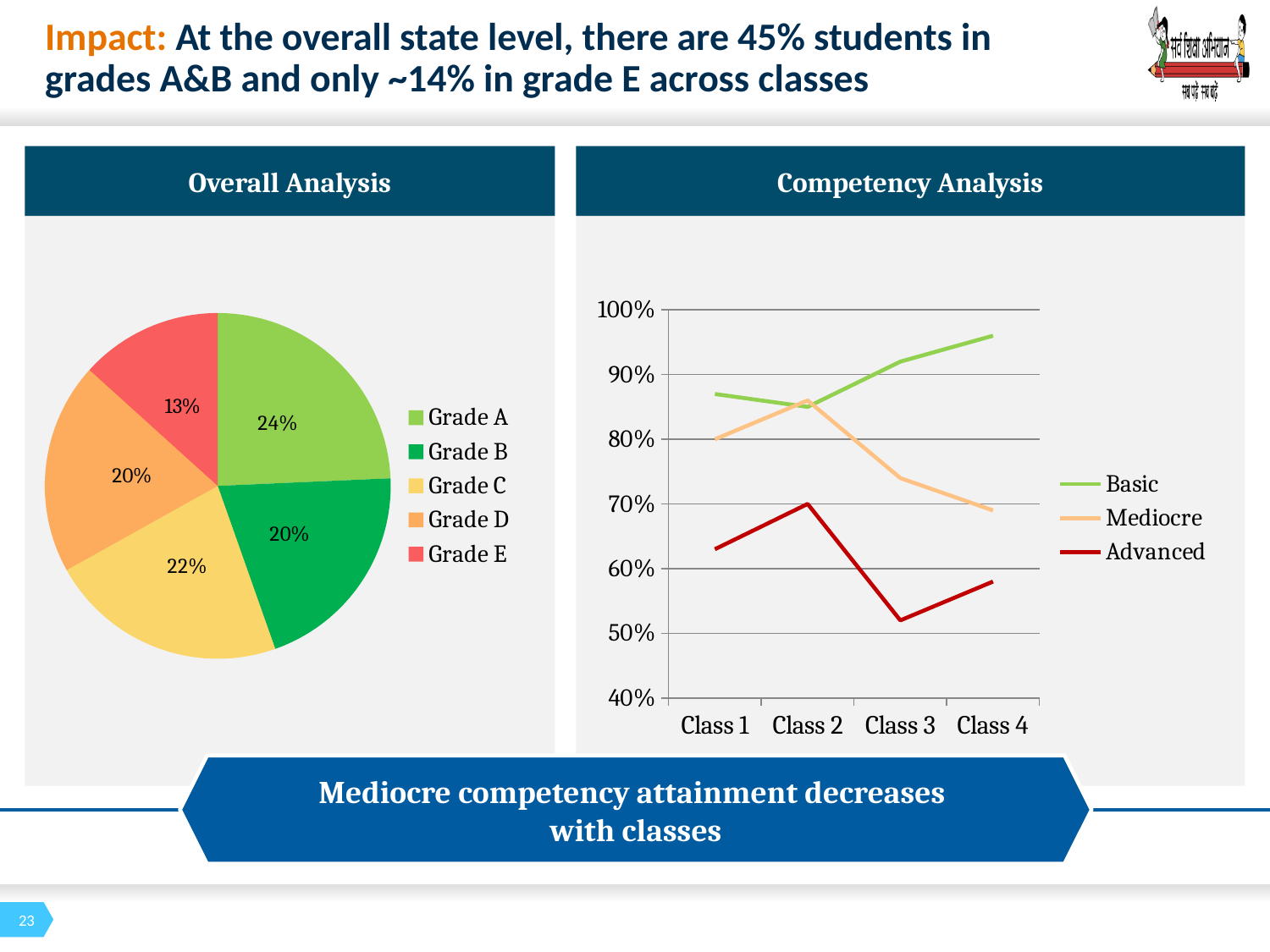
What kind of chart is the Competency Analysis chart? Line chart In the Overall Analysis pie chart, which grade has the smallest share? Grade E In the Competency Analysis chart, is the Advanced value for Class 3 greater or less than 60%? less In the Overall Analysis pie chart, what percentage of students are in Grade E? 13% In the Overall Analysis pie chart, which grade has the largest share? Grade A In the Competency Analysis chart, is the Basic value for Class 4 greater or less than 90%? greater In the Overall Analysis pie chart, what percentage of students are in Grade A? 24% How many grade categories are shown in the Overall Analysis pie chart? 5 How many series does the legend of the Competency Analysis chart list? 3 In the Competency Analysis chart, does the Mediocre line rise or fall from Class 2 to Class 4? fall In the Overall Analysis pie chart, which is larger, the share for Grade C or the share for Grade B? Grade C In the Overall Analysis pie chart, what is the difference in percentage points between Grade A and Grade E? 11%